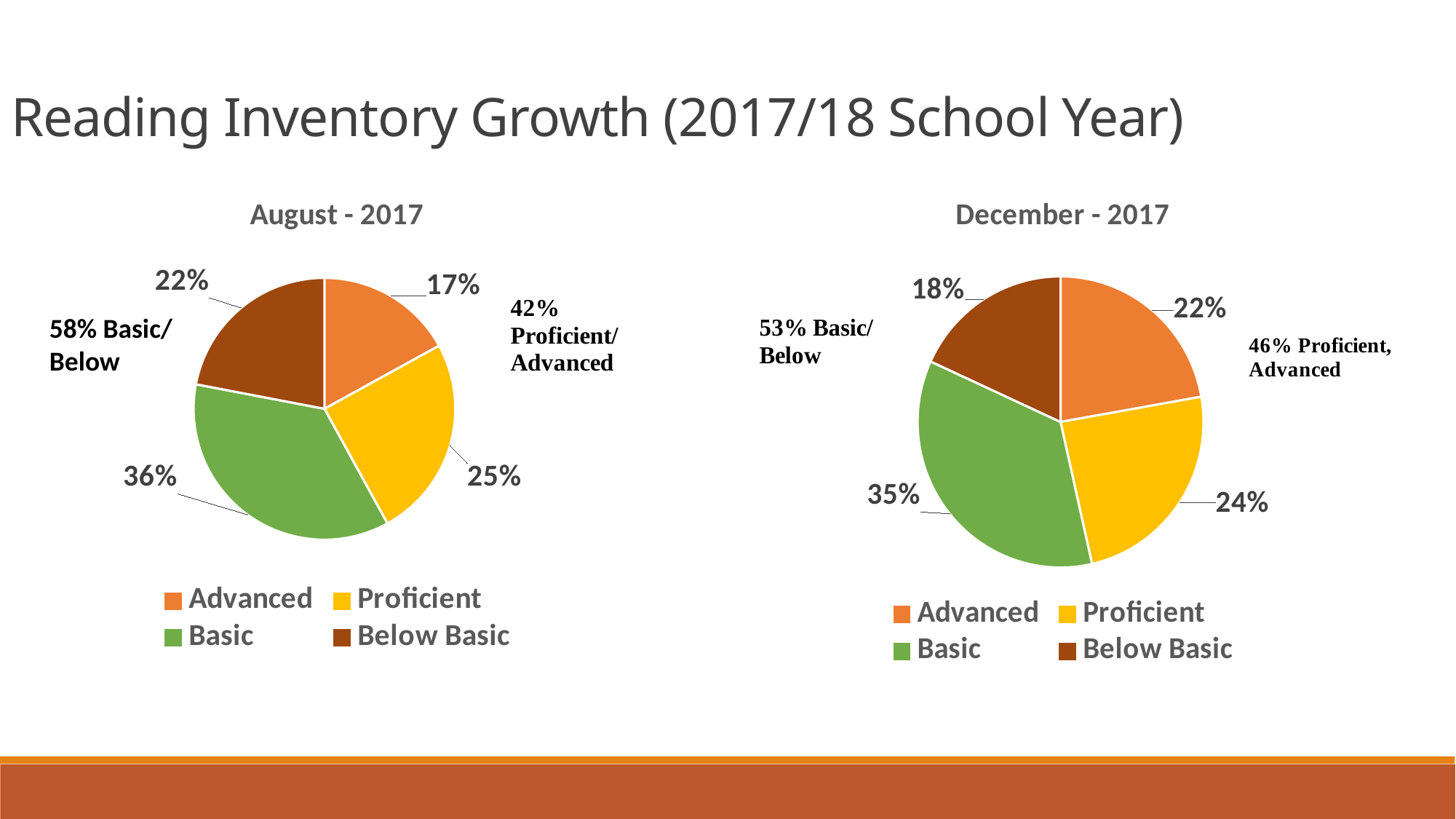
In the August - 2017 chart, what percentage is Advanced? 17% In the December - 2017 chart, which category has the smallest slice? Below Basic In the August - 2017 chart, what percentage is Basic? 36% In the August - 2017 chart, which category has the largest slice? Basic What type of chart is the August - 2017 chart? Pie chart In the August - 2017 chart, which is larger, Proficient or Below Basic? Proficient In the August - 2017 chart, which category has the smallest slice? Advanced In the December - 2017 chart, what percentage is Proficient? 24% In the December - 2017 chart, what colour is the Basic slice? Green In the December - 2017 chart, what percentage is Below Basic? 18% How many slices does the December - 2017 pie chart have? 4 In the December - 2017 chart, what is the difference between the Basic and Advanced percentages? 13%